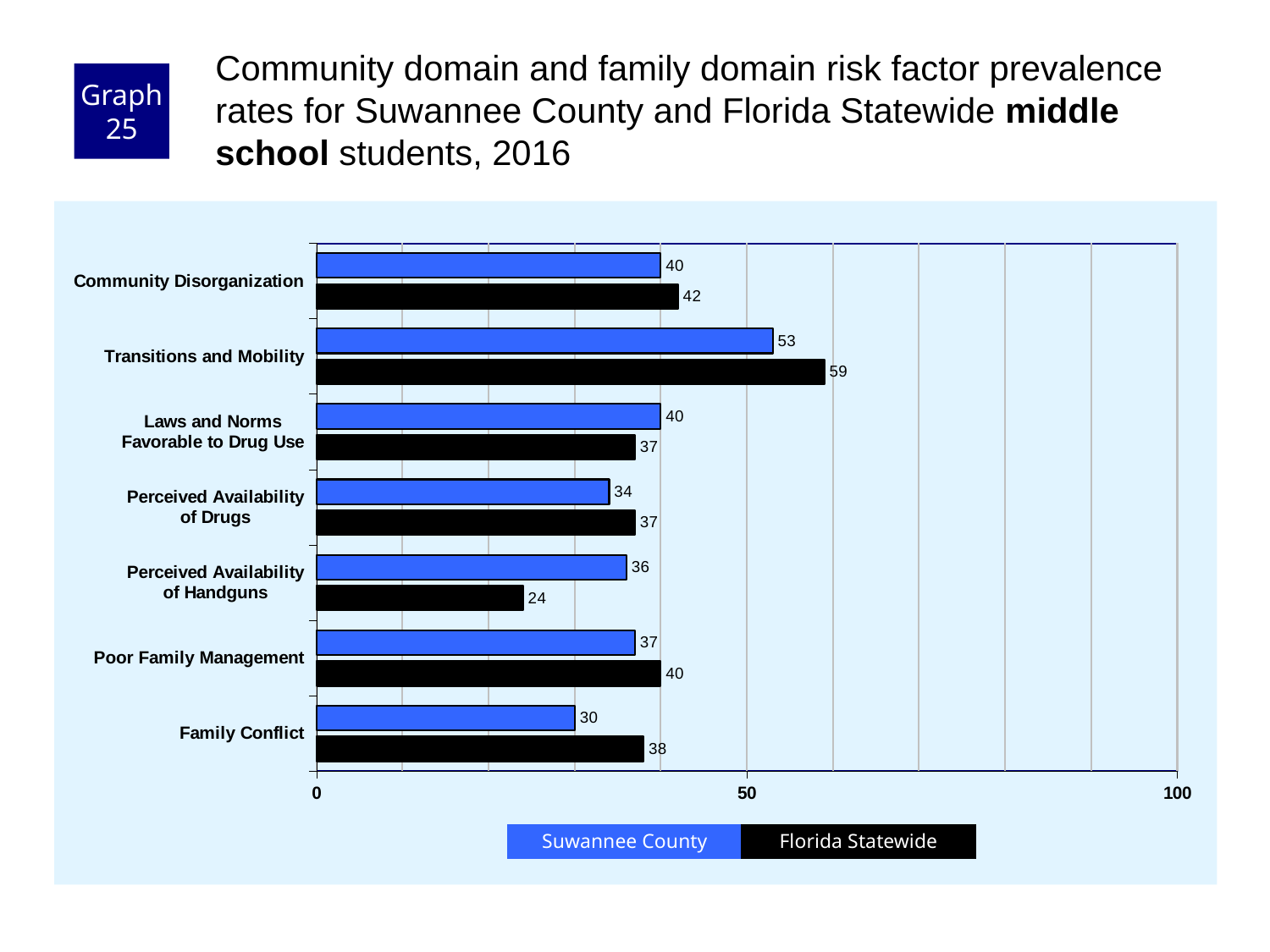
How many risk factor categories are shown on the chart? 7 Which category has the highest Florida Statewide value? Transitions and Mobility Which category has the lowest Suwannee County value? Family Conflict What is the Suwannee County value for Transitions and Mobility? 53 Which colour represents Florida Statewide in the chart? black What kind of chart is shown on the slide? bar chart Which is larger for Perceived Availability of Handguns: Suwannee County or Florida Statewide? Suwannee County What is the difference between the Florida Statewide and Suwannee County values for Transitions and Mobility? 6 Is the Florida Statewide value for Transitions and Mobility greater or less than 50? greater What is the Suwannee County value for Family Conflict? 30 How many series does the legend list? 2 What is the Florida Statewide value for Perceived Availability of Handguns? 24